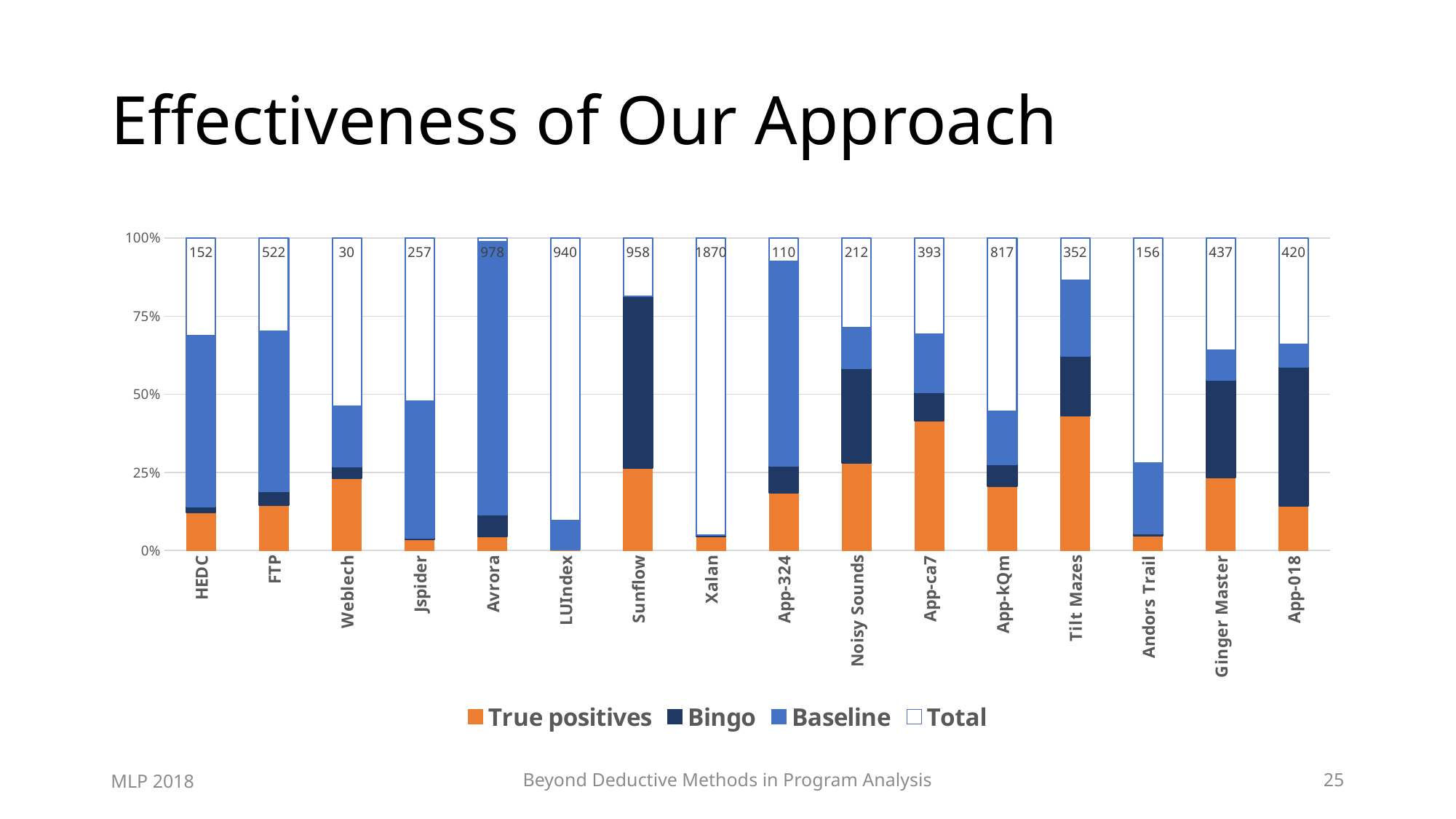
What is the Total value shown for Weblech? 30 What is the Total value shown for Xalan? 1870 What kind of chart is shown on the slide? Stacked bar chart What is the Total value shown for App-kQm? 817 Is the True positives value for Tilt Mazes greater or less than 25%? greater Which category has the highest Total value? Xalan How many series does the legend list? 4 Is the top of the Baseline segment for LUIndex greater or less than 25%? less What is the difference between the Total values for Xalan and Avrora? 892 Which has a larger Total value, FTP or Jspider? FTP How many categories are shown on the x axis? 16 Which category has the lowest Total value? Weblech